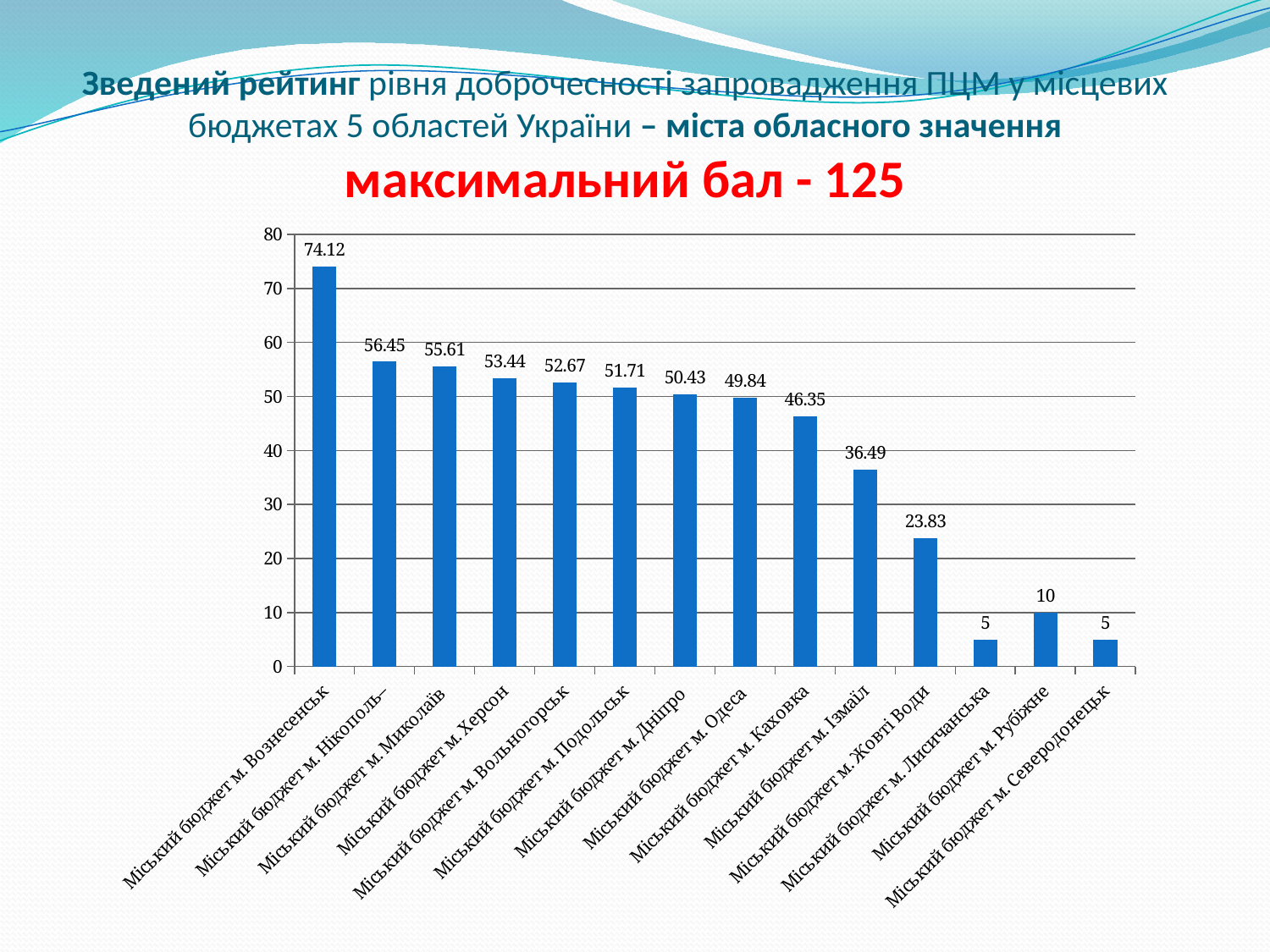
How many categories are shown in the chart? 14 What is the value for Міський бюджет м. Жовті Води? 23.83 What is the value for Міський бюджет м. Херсон? 53.44 What is the value for Міський бюджет м. Рубіжне? 10 What is the difference between the values for Міський бюджет м. Вознесенськ and Міський бюджет м. Нікополь? 17.67 Which is larger, the value for Міський бюджет м. Каховка or the value for Міський бюджет м. Ізмаїл? Міський бюджет м. Каховка Is the value for Міський бюджет м. Одеса greater or less than 50? less What is the value for Міський бюджет м. Вознесенськ? 74.12 Which category has the highest value? Міський бюджет м. Вознесенськ What maximum score is stated in red in the slide title? 125 What is the difference between the values for Міський бюджет м. Ізмаїл and Міський бюджет м. Жовті Води? 12.66 What kind of chart is shown on the slide? bar chart